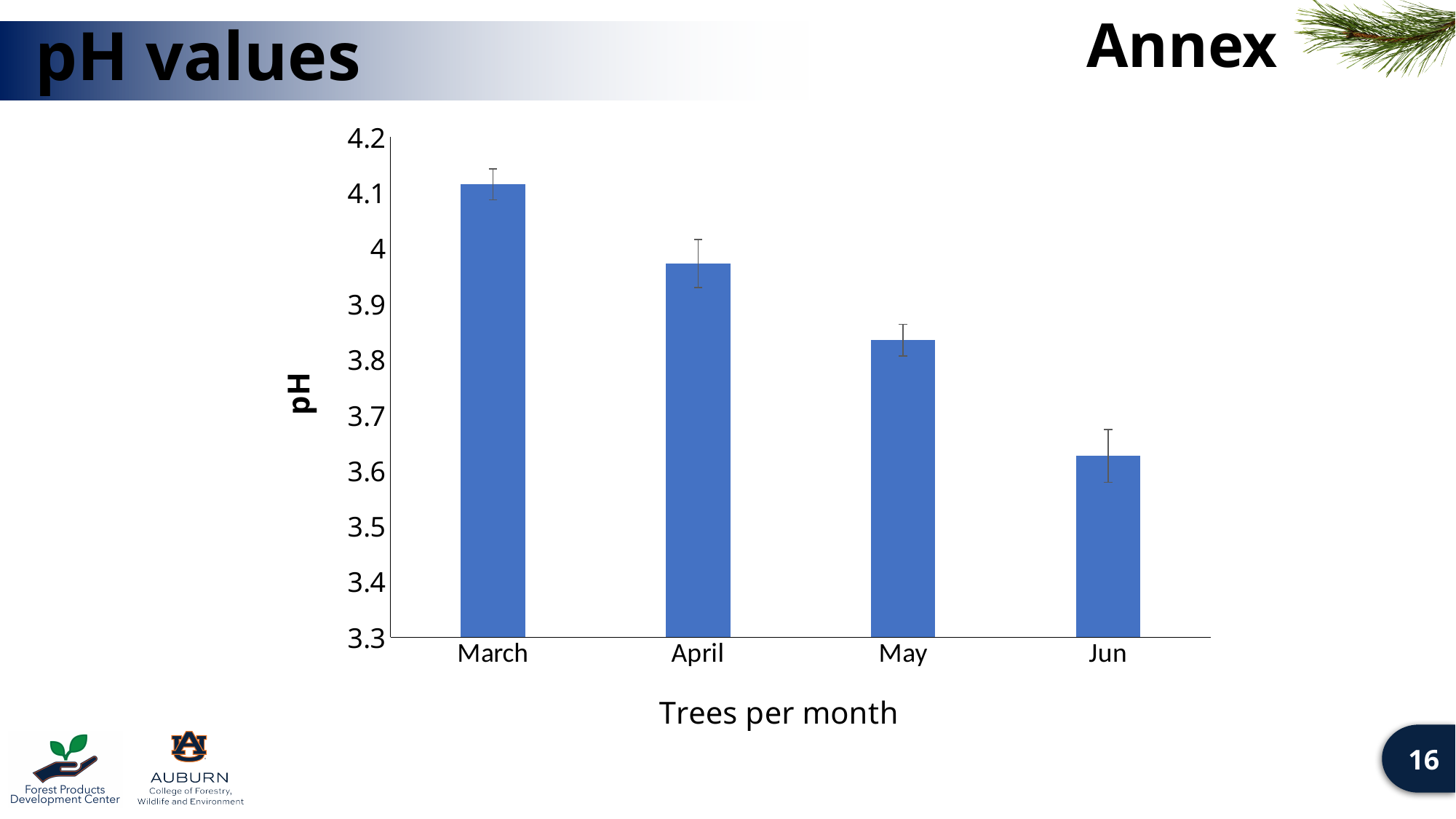
Is the pH value for March greater or less than 4? greater Which month has the lowest pH value? Jun What kind of chart is shown on the slide? Bar chart Which month has the highest pH value? March Is the pH value for May greater or less than 3.9? less Which has a higher pH value, March or April? March Which has a lower pH value, May or Jun? Jun Is the pH value for April greater or less than 3.9? greater How many months are shown on the x axis of the chart? 4 Do the pH values rise or fall from March to Jun? Fall What is the label on the x axis of the chart? Trees per month